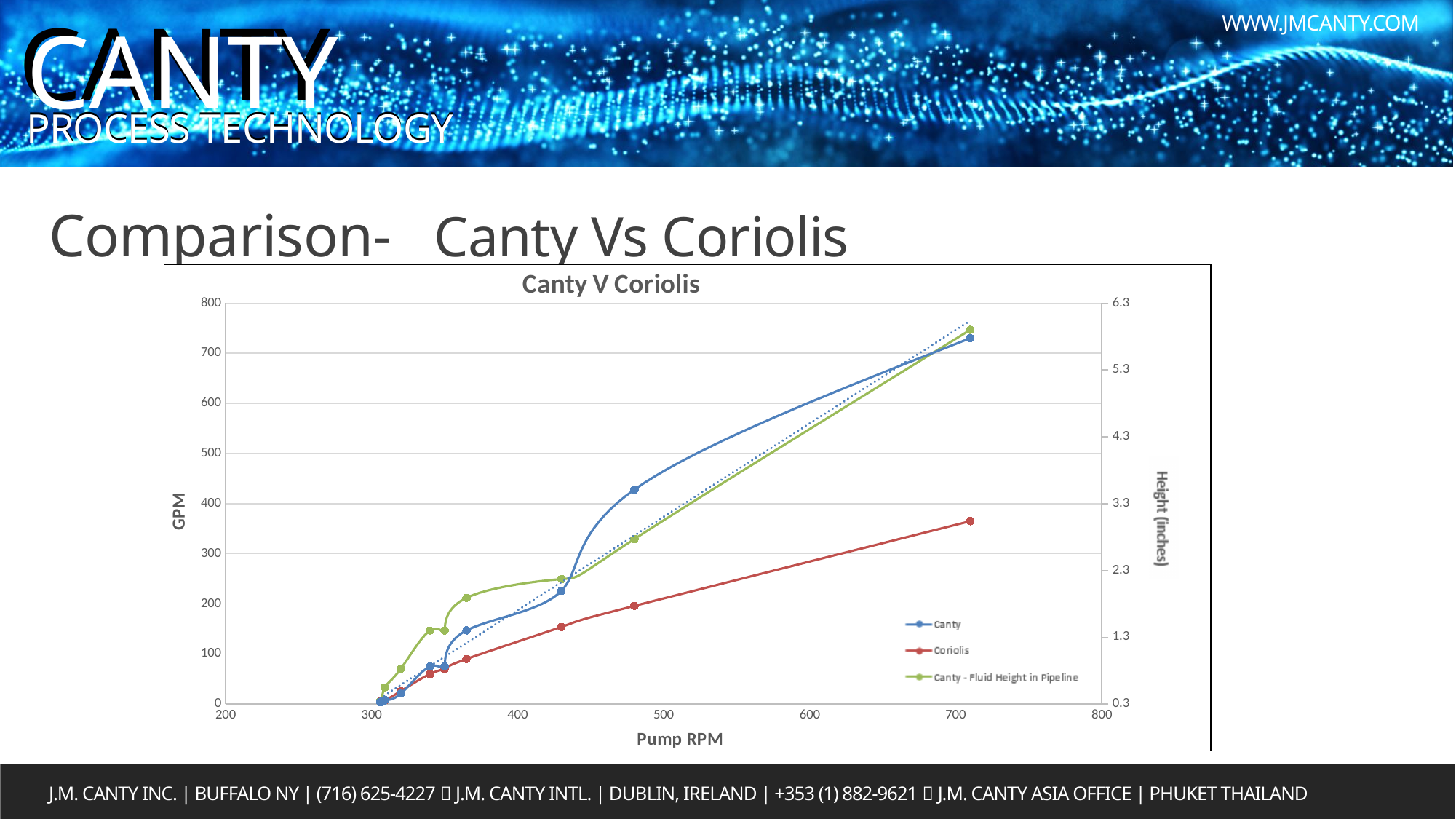
Is the Canty GPM value at about 365 RPM greater or less than 100? greater Is the Canty GPM value at about 480 RPM greater or less than 400? greater Do the Coriolis GPM values rise or fall as pump RPM increases? rise What type of chart is shown on the slide? Line chart Which series reaches the highest GPM value on the chart? Canty Is the Coriolis GPM value at about 710 RPM greater or less than 400? less What is the title of the chart? Canty V Coriolis How many series does the chart legend list? 3 What is the label of the x axis? Pump RPM Which series has the lowest GPM value at the highest pump RPM plotted? Coriolis At the highest pump RPM plotted, which series has the larger GPM value, Canty or Coriolis? Canty